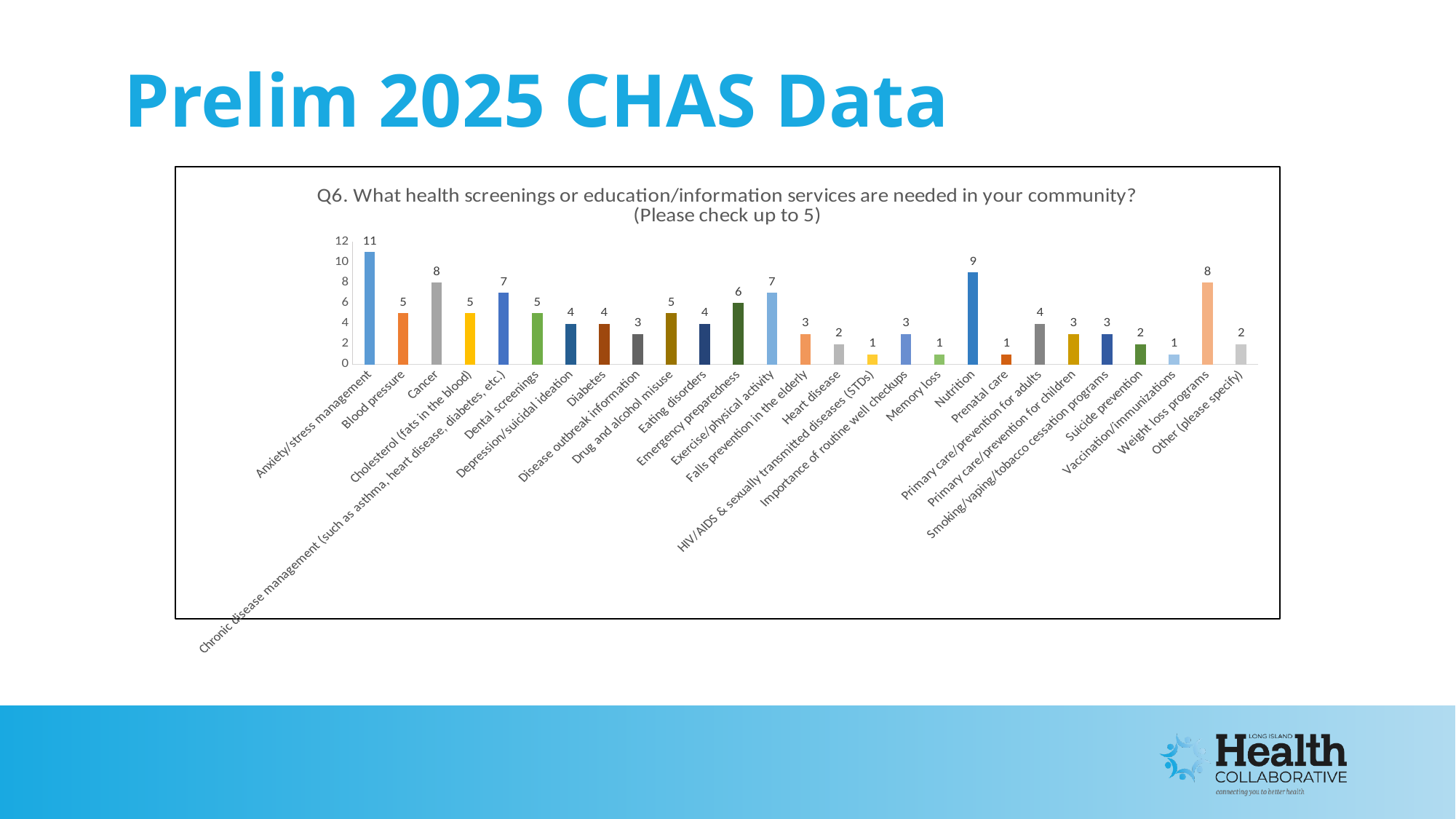
What type of chart is shown on the slide? Bar chart Which category has the highest value? Anxiety/stress management What is the value for Anxiety/stress management? 11 What is the value for Nutrition? 9 Which has a larger value, Exercise/physical activity or Blood pressure? Exercise/physical activity What is the value for Emergency preparedness? 6 What is the difference between the values for Anxiety/stress management and Nutrition? 2 What is the difference between the values for Cancer and Heart disease? 6 What is the maximum value shown on the y axis? 12 What is the value for Weight loss programs? 8 What is the value for Memory loss? 1 How many categories are shown on the x axis? 27